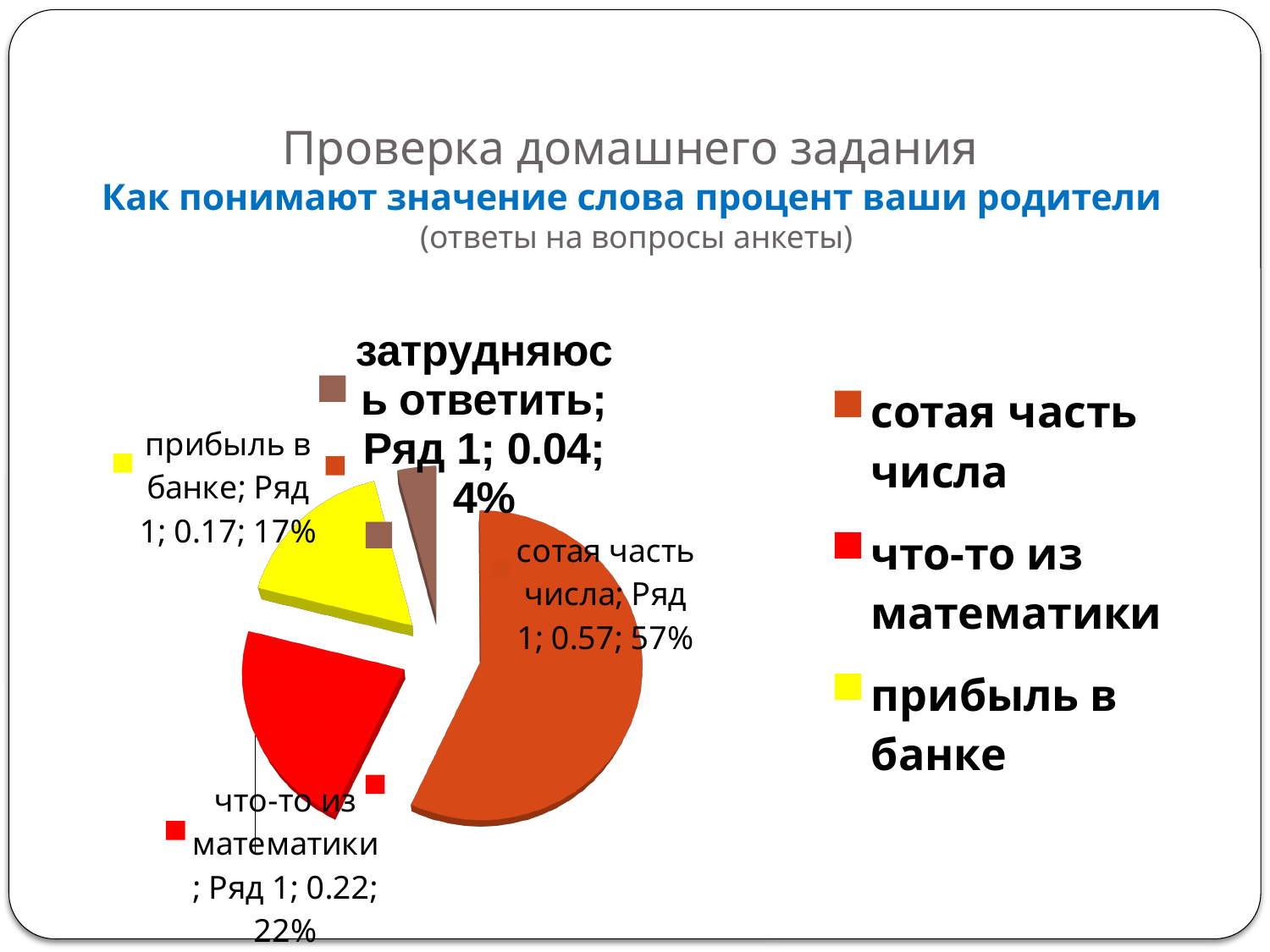
Which slice of the pie is the largest? сотая часть числа Which slice of the pie is the smallest? затрудняюсь ответить What is the decimal value printed in the data label for the "прибыль в банке" slice? 0.17 What share of the pie does the slice "сотая часть числа" represent? 57% What share of the pie does the slice "затрудняюсь ответить" represent? 4% Which slice is larger: "что-то из математики" or "прибыль в банке"? что-то из математики What colour is the "сотая часть числа" slice in the legend? orange-red How many slices does the pie chart have? 4 What share of the pie does the slice "что-то из математики" represent? 22% What is the difference in percentage points between the "сотая часть числа" slice and the "что-то из математики" slice? 35% What kind of chart is shown on the slide? pie chart